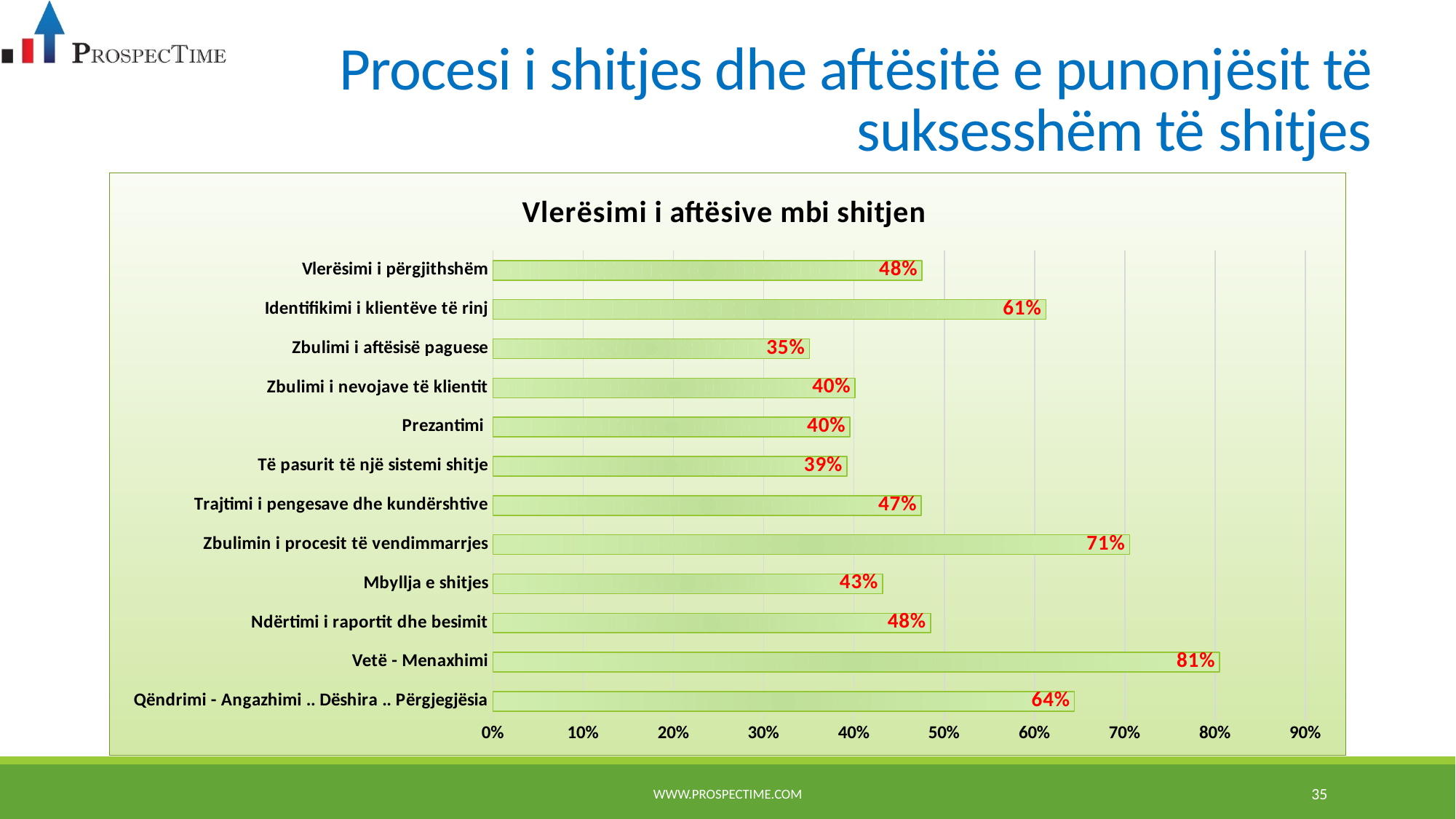
Which category has the lowest value? Zbulimi i aftësisë paguese What is the title of the chart? Vlerësimi i aftësive mbi shitjen Is the value for Qëndrimi - Angazhimi .. Dëshira .. Përgjegjësia greater or less than 60%? greater What is the difference between Vetë - Menaxhimi and Zbulimin i procesit të vendimmarrjes? 10% How many categories are shown in the chart? 12 What is the value for Vlerësimi i përgjithshëm? 48% Which category has the highest value? Vetë - Menaxhimi What is the value for Zbulimi i aftësisë paguese? 35% What is the value for Identifikimi i klientëve të rinj? 61% What kind of chart is shown on the slide? bar chart Which is larger, Mbyllja e shitjes or Trajtimi i pengesave dhe kundërshtive? Trajtimi i pengesave dhe kundërshtive What is the value for Vetë - Menaxhimi? 81%